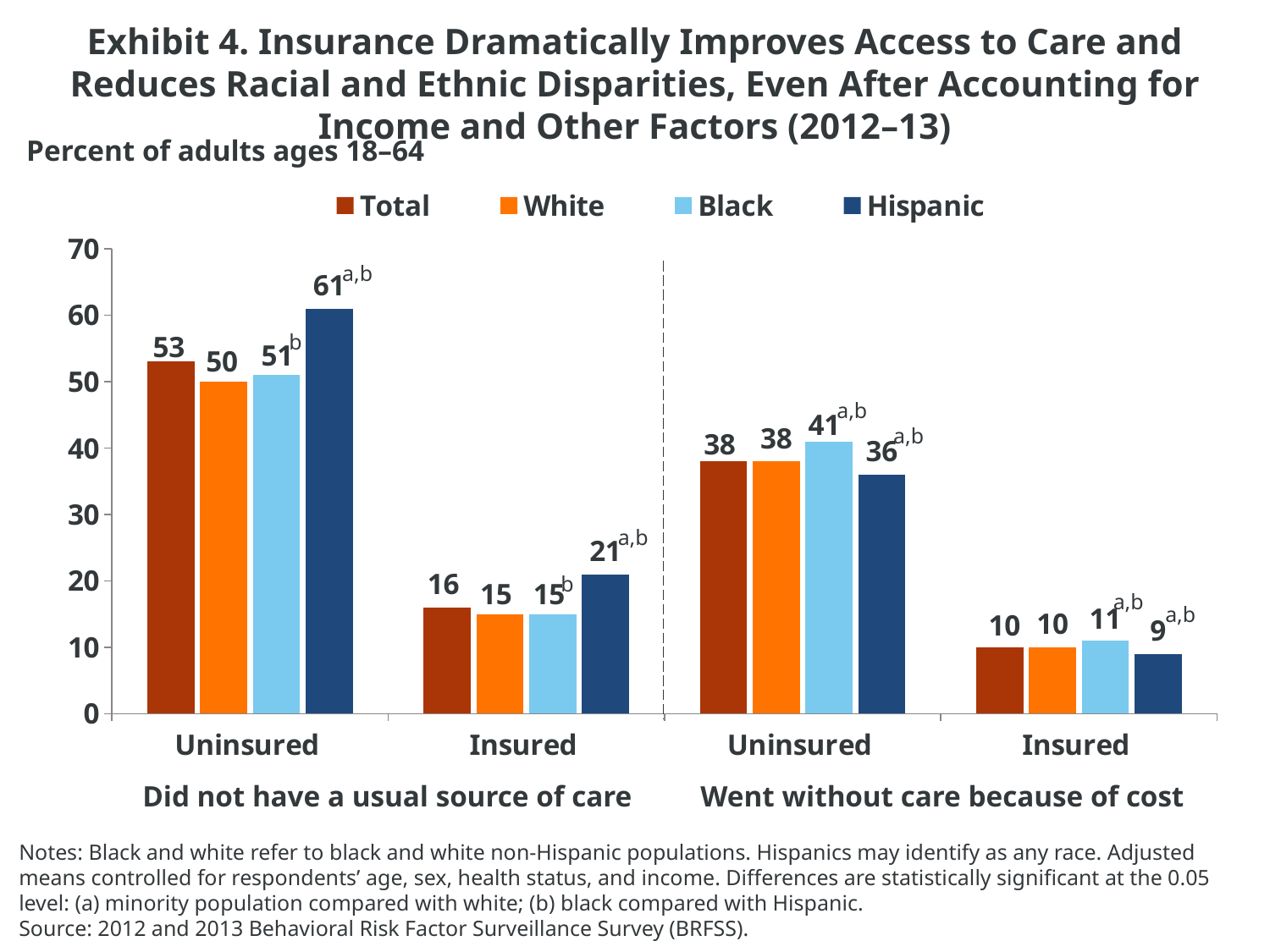
What kind of chart is shown on the slide? bar chart What is the difference between the Hispanic and White values in the Uninsured group under 'Did not have a usual source of care'? 11 Which is larger: the Black value or the Hispanic value in the Uninsured group under 'Went without care because of cost'? Black What colour represents the Hispanic series in the legend? dark blue What is the value for Hispanic adults in the Uninsured group under 'Did not have a usual source of care'? 61 How many series does the legend list? 4 Is the Total value for the Uninsured group under 'Did not have a usual source of care' greater or less than 50? greater Which series has the lowest value in the Insured group under 'Went without care because of cost'? Hispanic What is the value for Total in the Insured group under 'Did not have a usual source of care'? 16 What is the difference between the Uninsured and Insured Total values under 'Went without care because of cost'? 28 What is the value for Black adults in the Uninsured group under 'Went without care because of cost'? 41 Which series has the highest value in the Uninsured group under 'Did not have a usual source of care'? Hispanic